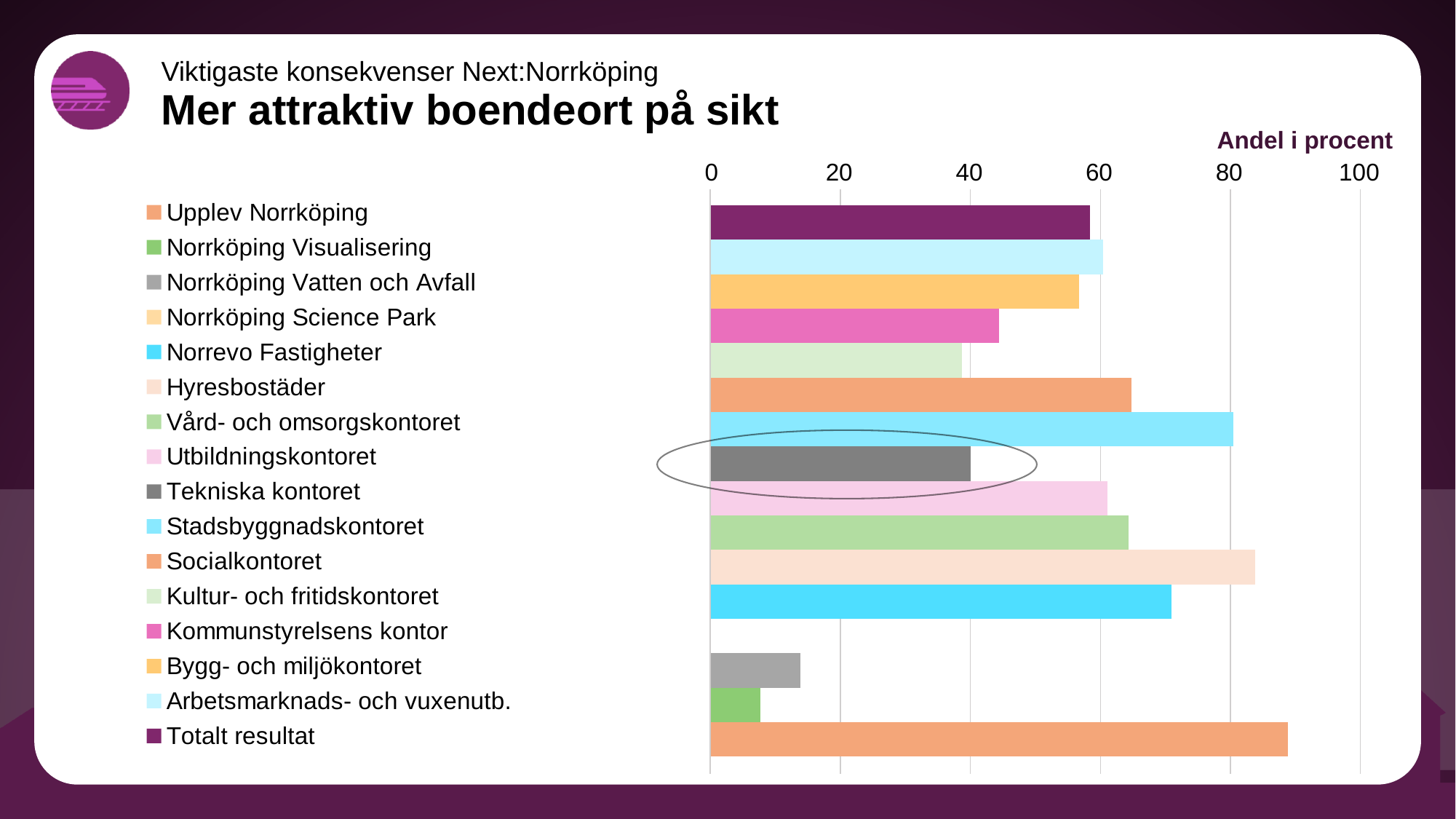
Which has the larger value, Stadsbyggnadskontoret or Tekniska kontoret? Stadsbyggnadskontoret Is the value for Norrköping Vatten och Avfall greater or less than 20? less What is the main title of the slide above the chart? Mer attraktiv boendeort på sikt Is the value for Stadsbyggnadskontoret greater or less than 60? greater Is the value for Tekniska kontoret greater or less than 60? less What is the axis title shown above the horizontal axis of the chart? Andel i procent Which has the larger value, Hyresbostäder or Socialkontoret? Hyresbostäder Which legend entry has the longest bar in the chart? Upplev Norrköping How many entries does the chart legend list? 16 What kind of chart is shown on the slide? bar chart